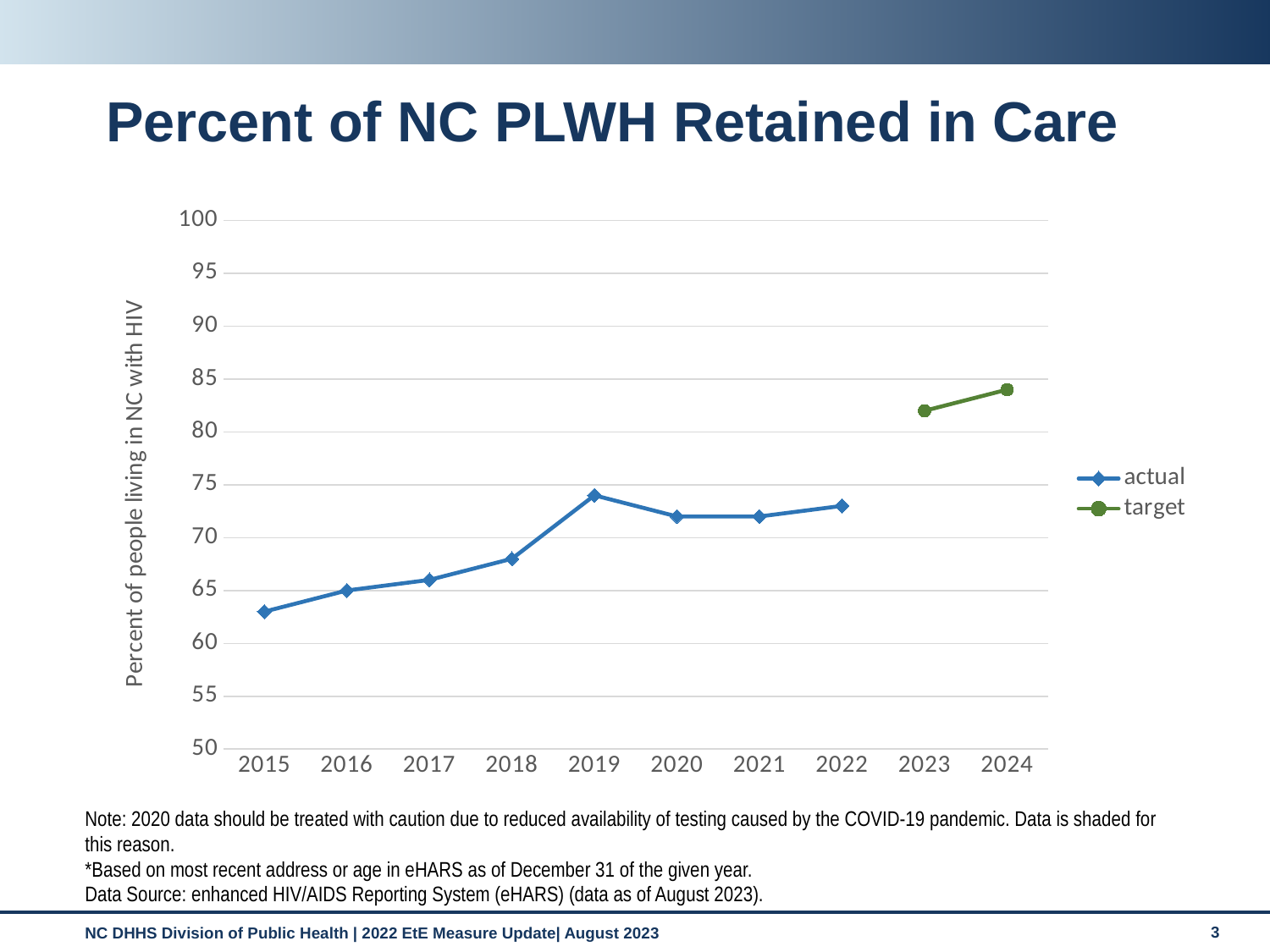
Is the actual value for 2018 greater or less than 70? less Is the target value for 2023 greater or less than 80? greater In which year is the actual series at its lowest? 2015 What are the two series named in the legend? actual and target Does the actual series rise or fall from 2015 to 2019? rise What kind of chart is shown on the slide? line chart Which is larger, the actual value for 2019 or the actual value for 2015? 2019 Is the actual value for 2015 greater or less than 65? less How many series does the legend list? 2 In which year is the actual series at its highest? 2019 How many data points does the actual series have? 8 How many years are shown on the x axis? 10